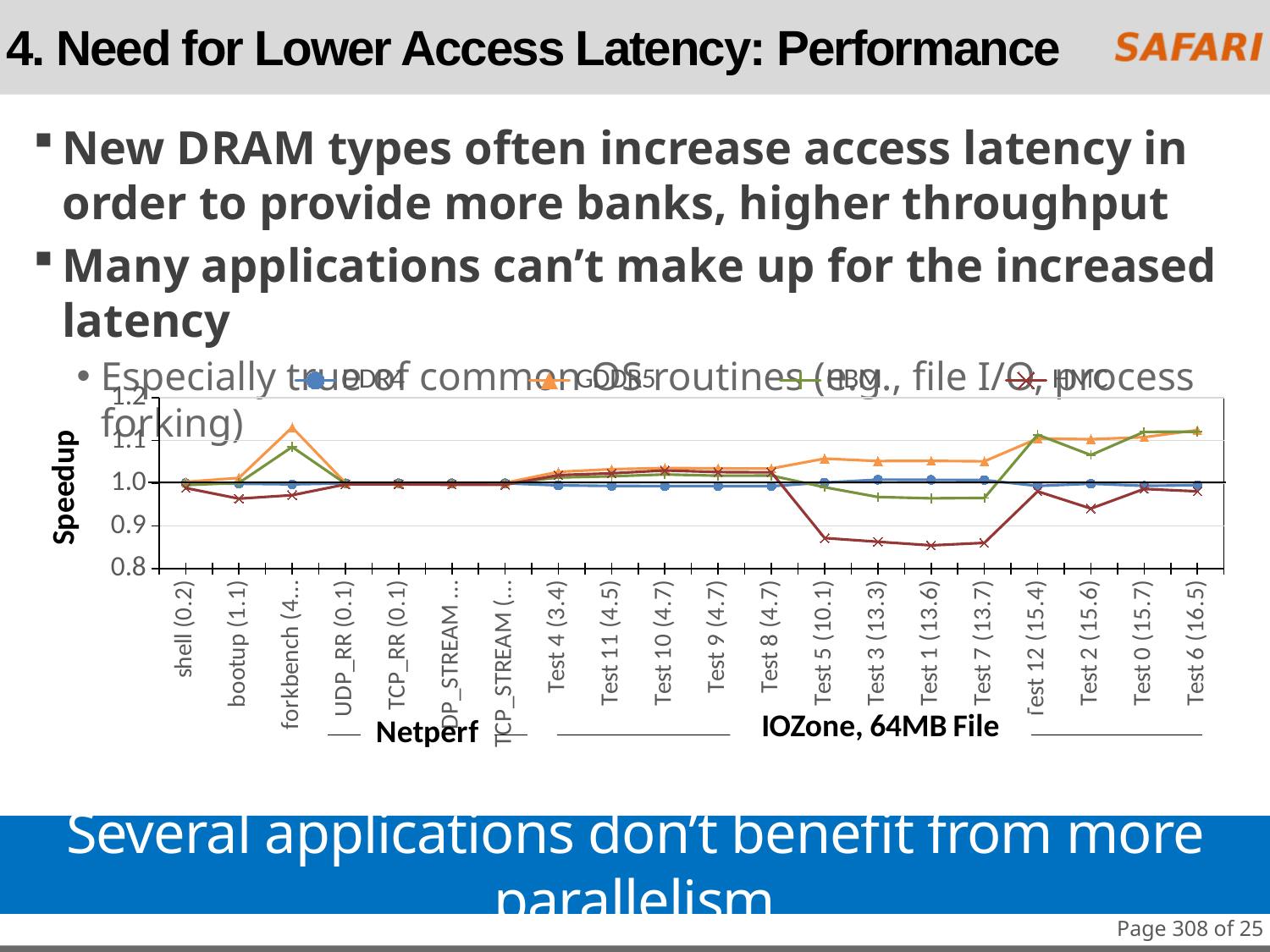
Is the GDDR5 value for forkbench greater or less than 1.1? greater Which series has the highest speedup at forkbench? GDDR5 Is the HBM value for Test 3 (13.3) greater or less than 1.0? less How many series does the chart's legend list? 4 Is the GDDR5 value for Test 6 (16.5) greater or less than 1.0? greater How many categories are plotted along the x axis of the chart? 20 What is the label of the y axis of the chart? Speedup What kind of chart is shown on the slide? line chart